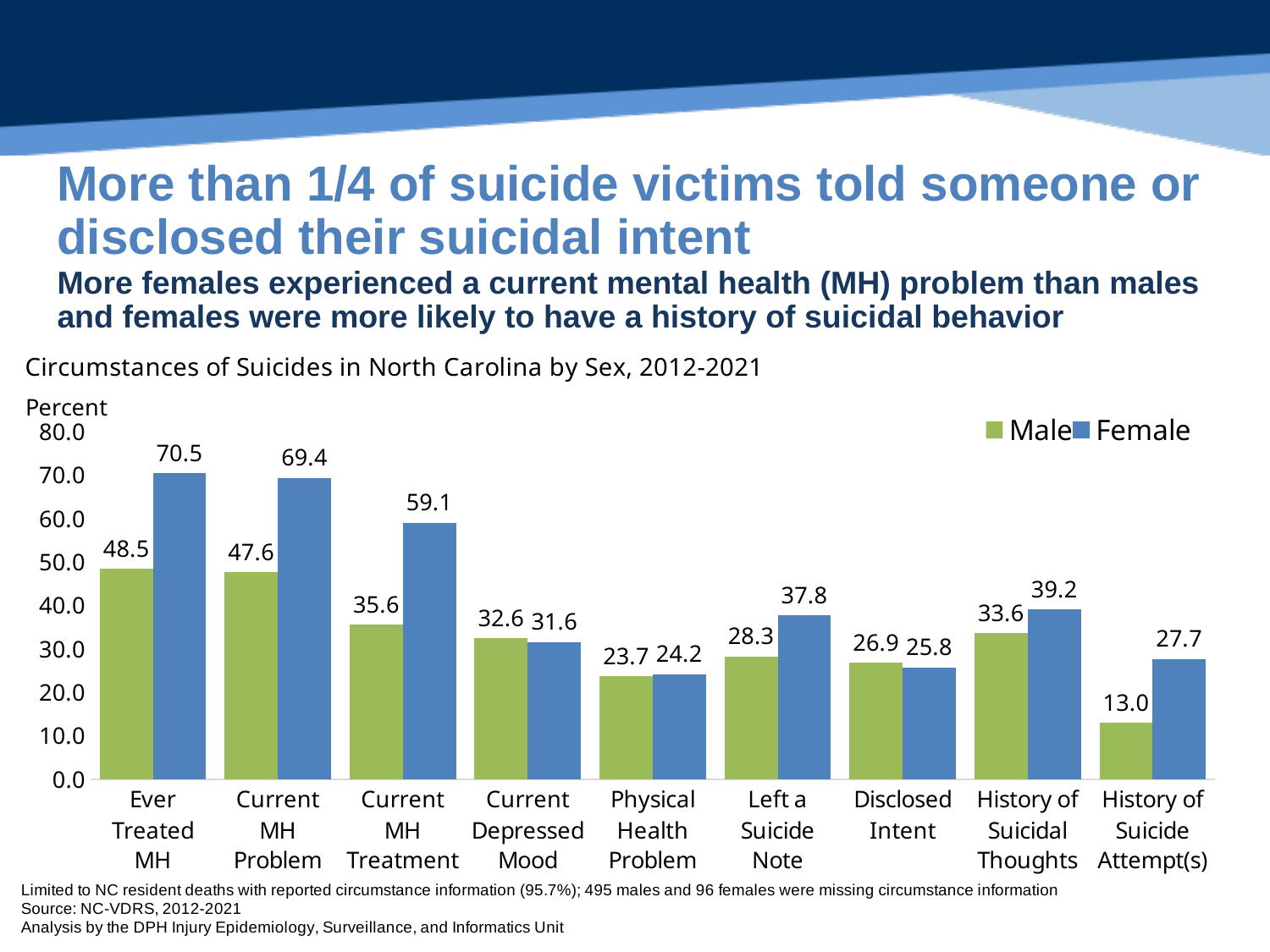
What is the Male value for History of Suicide Attempt(s)? 13.0 Which is larger, the Male or Female value for Current Depressed Mood? Male What is the Female value for Ever Treated MH? 70.5 What is the difference between the Female and Male values for Current MH Treatment? 23.5 How many series does the legend list? 2 Which category has the highest Female value? Ever Treated MH Which is larger, the Male or Female value for Left a Suicide Note? Female Which category has the lowest Male value? History of Suicide Attempt(s) What is the Male value for Disclosed Intent? 26.9 What is the title of the chart? Circumstances of Suicides in North Carolina by Sex, 2012-2021 How many categories are shown on the x axis? 9 What kind of chart is shown on the slide? Bar chart